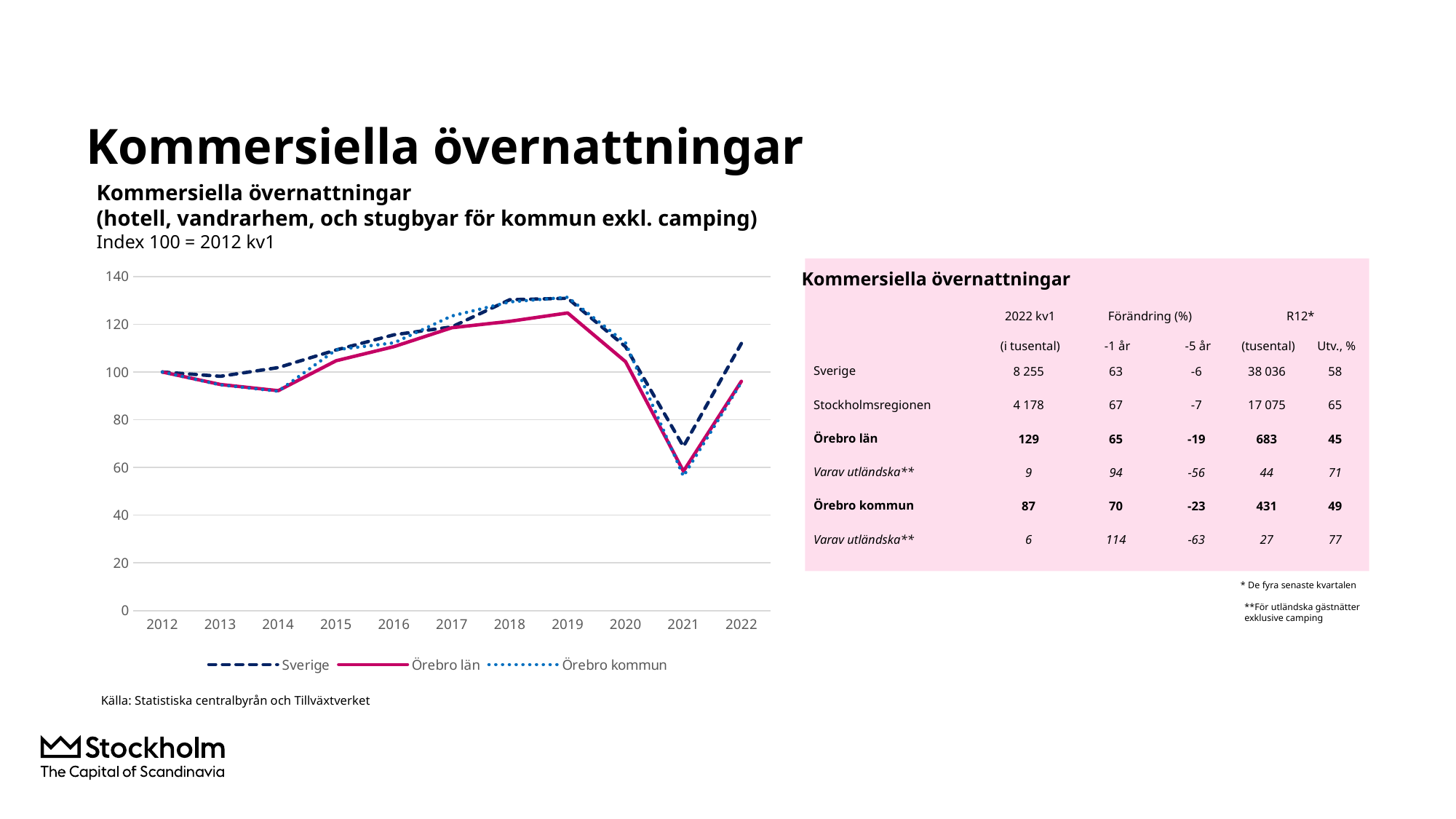
Is the value for Örebro län in 2014 greater or less than 100? less Is the value for Sverige in 2021 greater or less than 80? less How many years are plotted along the x axis of the chart? 11 Is the value for Örebro län in 2019 greater or less than 120? greater In 2021, which is larger: the value for Sverige or the value for Örebro län? Sverige What is the index base stated for the chart? Index 100 = 2012 kv1 In which year does the Sverige series reach its lowest value? 2021 In which year does the Örebro län series reach its lowest value? 2021 Which series are listed in the chart legend? Sverige, Örebro län, Örebro kommun How many series does the chart legend list? 3 What kind of chart is shown on the slide? line chart What is the index value for all three series in 2012? 100